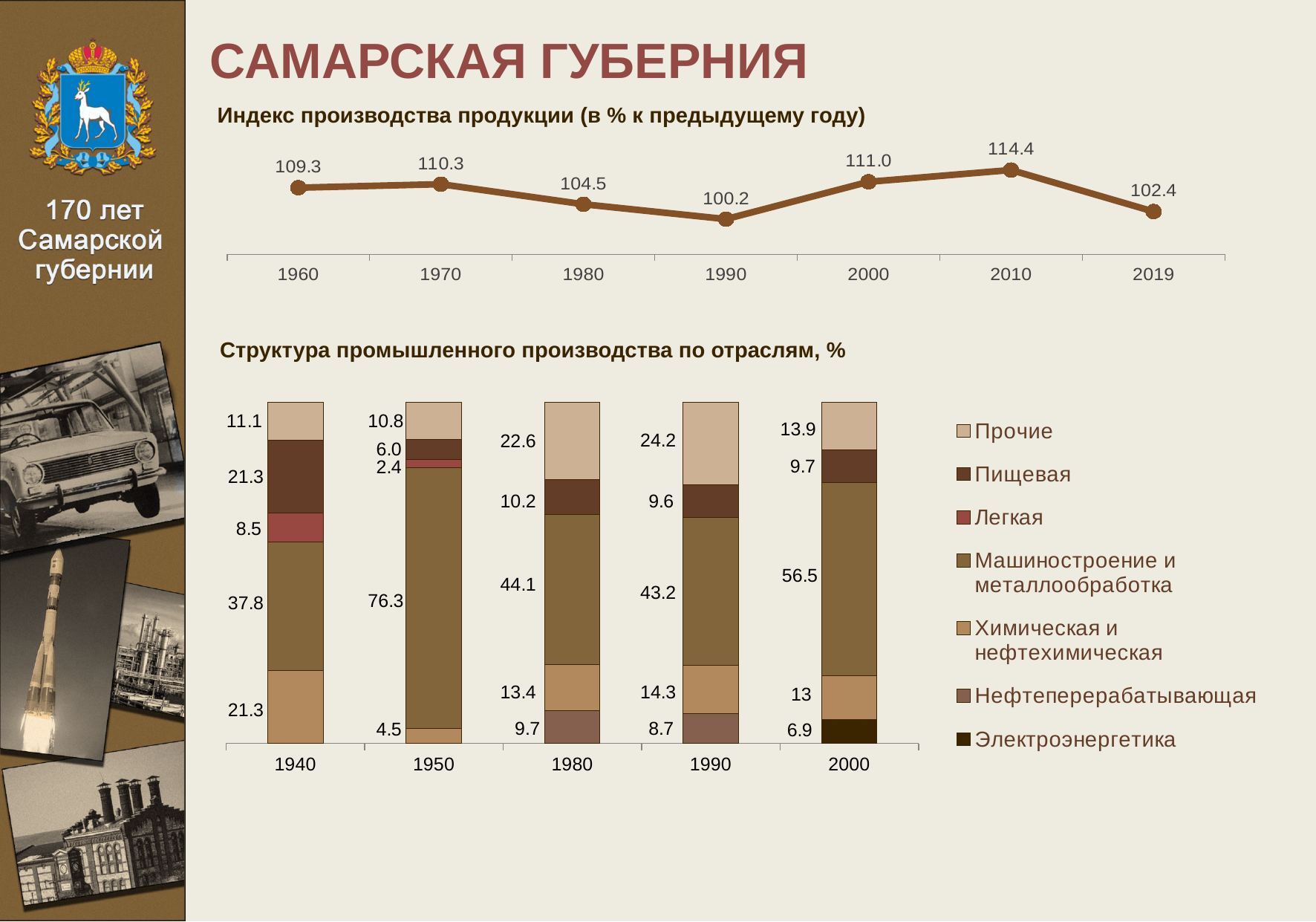
In the chart 'Структура промышленного производства по отраслям, %', how many series does the legend list? 7 In the chart 'Индекс производства продукции (в % к предыдущему году)', what is the difference between the values for 2010 and 2019? 12.0 What type of chart is 'Структура промышленного производства по отраслям, %'? Stacked bar chart In the chart 'Структура промышленного производства по отраслям, %', what is the total of the 1940 bar? 100.0 In the chart 'Индекс производства продукции (в % к предыдущему году)', how many data points are plotted? 7 In the chart 'Структура промышленного производства по отраслям, %', what is the value for 'Машиностроение и металлообработка' in 1950? 76.3 In the chart 'Структура промышленного производства по отраслям, %', which is larger: 'Прочие' in 1980 or 'Прочие' in 1990? 1990 What type of chart is 'Индекс производства продукции (в % к предыдущему году)'? Line chart In the chart 'Индекс производства продукции (в % к предыдущему году)', which year has the lowest value? 1990 In the chart 'Структура промышленного производства по отраслям, %', what is the value for 'Электроэнергетика' in 2000? 6.9 In the chart 'Индекс производства продукции (в % к предыдущему году)', what is the value for 2010? 114.4 In the chart 'Индекс производства продукции (в % к предыдущему году)', which year has the highest value? 2010